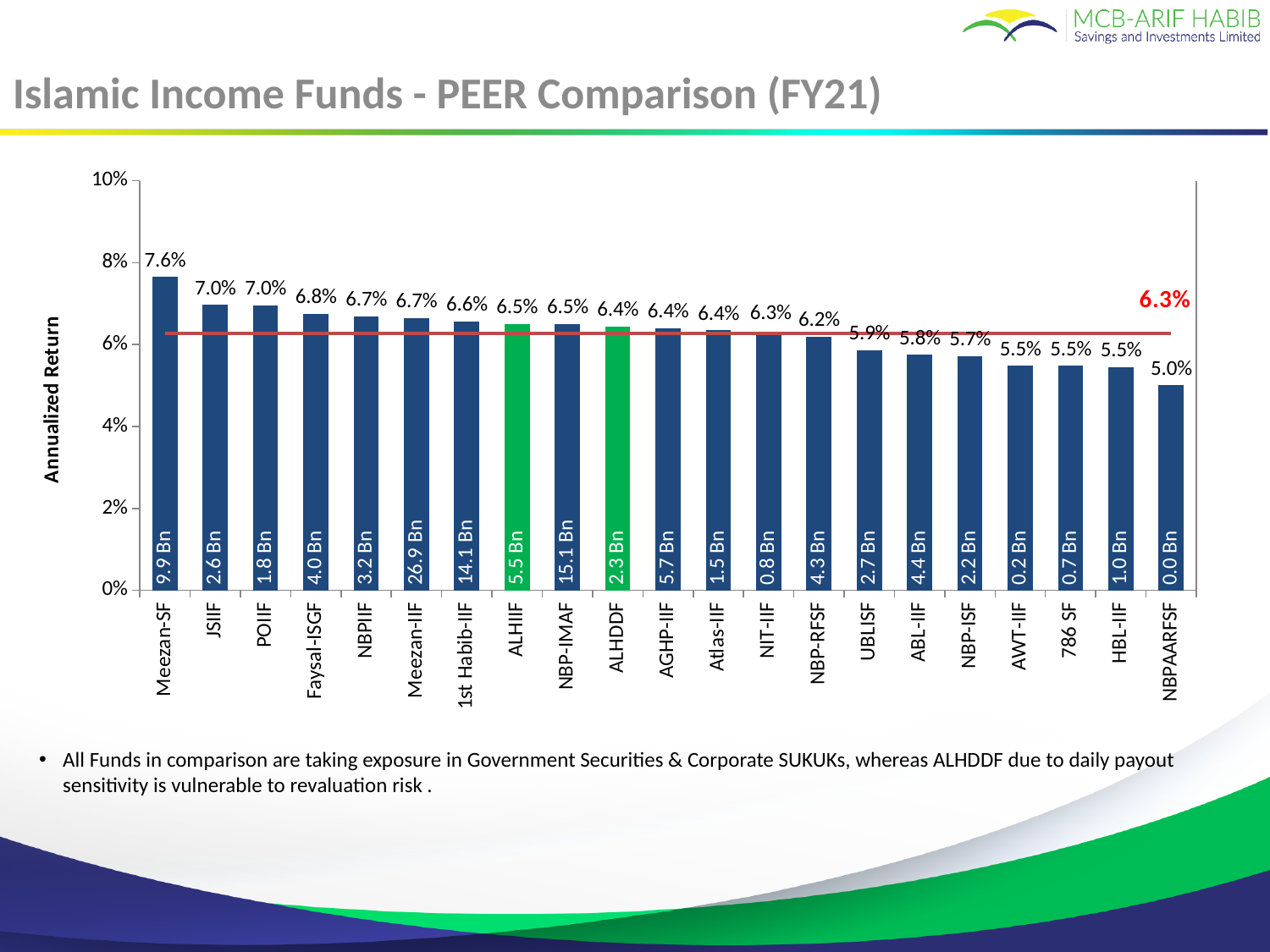
What fund size is printed on the bar for Meezan-IIF? 26.9 Bn Which has a higher annualized return, Faysal-ISGF or UBLISF? Faysal-ISGF Which fund has the highest annualized return? Meezan-SF What is the label of the vertical axis? Annualized Return How many funds are shown in the chart? 21 What is the annualized return for Meezan-SF? 7.6% What is the difference in annualized return between Meezan-SF and NBPAARFSF? 2.6% Which fund has the lowest annualized return? NBPAARFSF What value does the red horizontal line mark? 6.3% What is the annualized return for ALHDDF? 6.4% What is the annualized return for NBPAARFSF? 5.0% What type of chart is shown on the slide? Bar chart